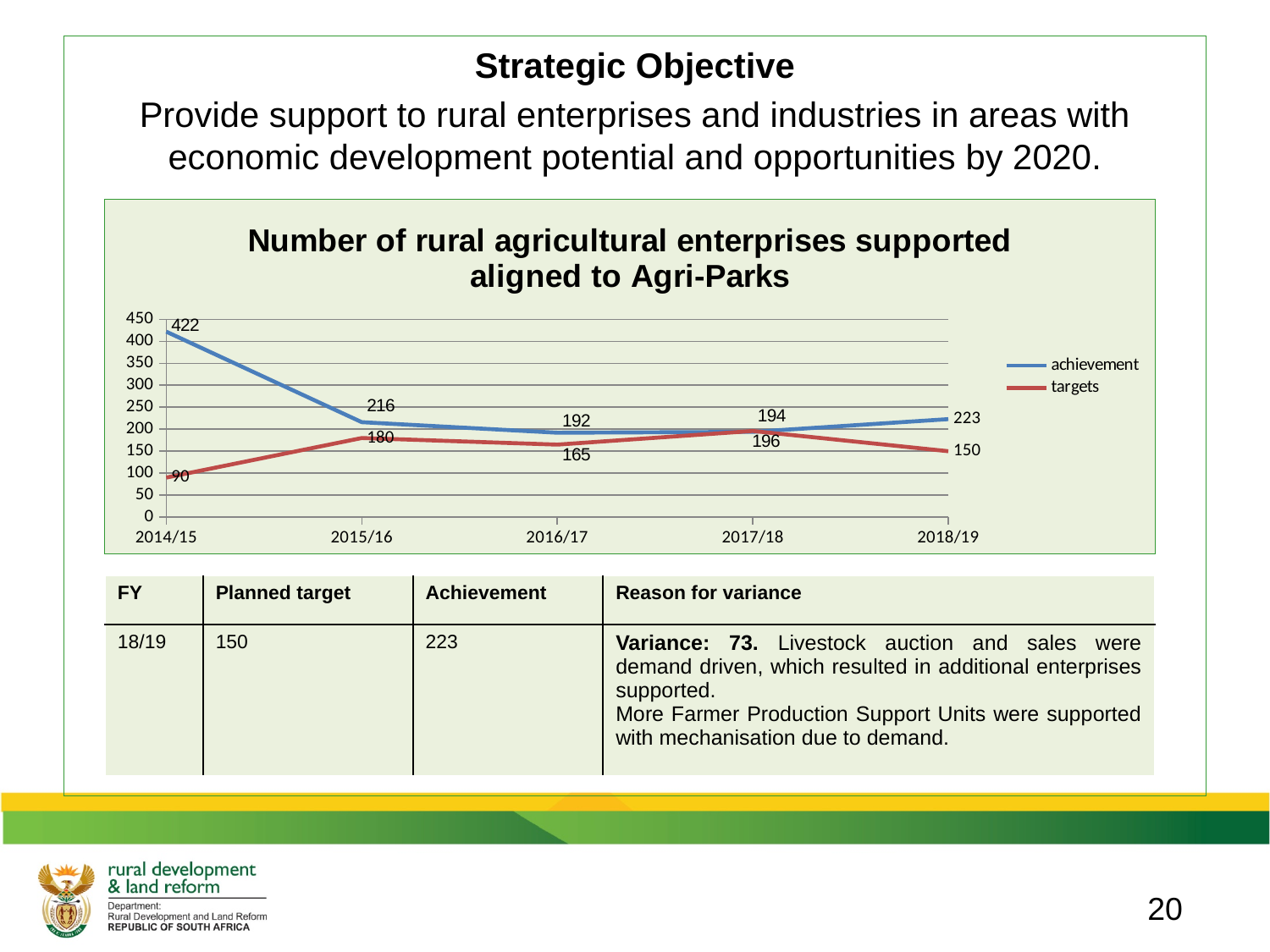
Does the achievement line rise or fall from 2014/15 to 2015/16? fall How many series does the legend of the chart list? 2 How many financial years are plotted along the x axis of the chart? 5 What is the targets value for 2018/19? 150 In which financial year is the targets value lowest? 2014/15 What kind of chart is shown on the slide? line chart In 2015/16, which is larger: the achievement or the target? achievement What is the targets value for 2014/15? 90 What is the achievement value for 2014/15? 422 What is the achievement value for 2018/19? 223 What is the difference between the achievement and the target in 2018/19? 73 In which financial year is the achievement value highest? 2014/15